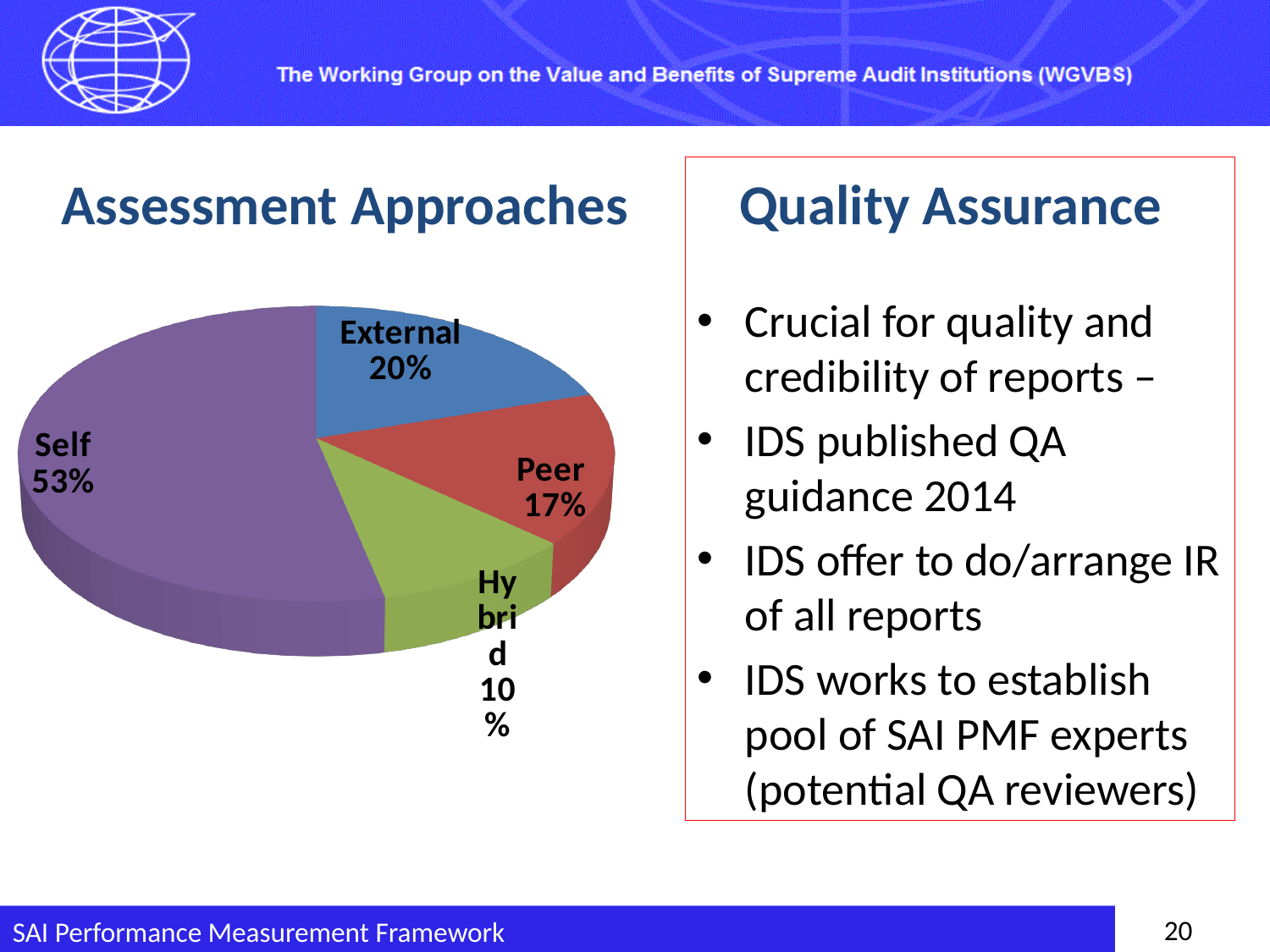
What is the difference in percentage points between the Peer and Hybrid slices? 7 What share of the pie does the Self slice represent? 53% What colour is the Self slice of the pie chart? Purple What type of chart is shown under the heading 'Assessment Approaches'? Pie chart Which assessment approach has the smallest share of the pie? Hybrid Which assessment approach has the largest share of the pie? Self What share of the pie does the Peer slice represent? 17% What is the difference in percentage points between the Self and External slices? 33 How many slices does the pie chart have? 4 Which slice is larger, External or Peer? External What share of the pie does the Hybrid slice represent? 10% What share of the pie does the External slice represent? 20%